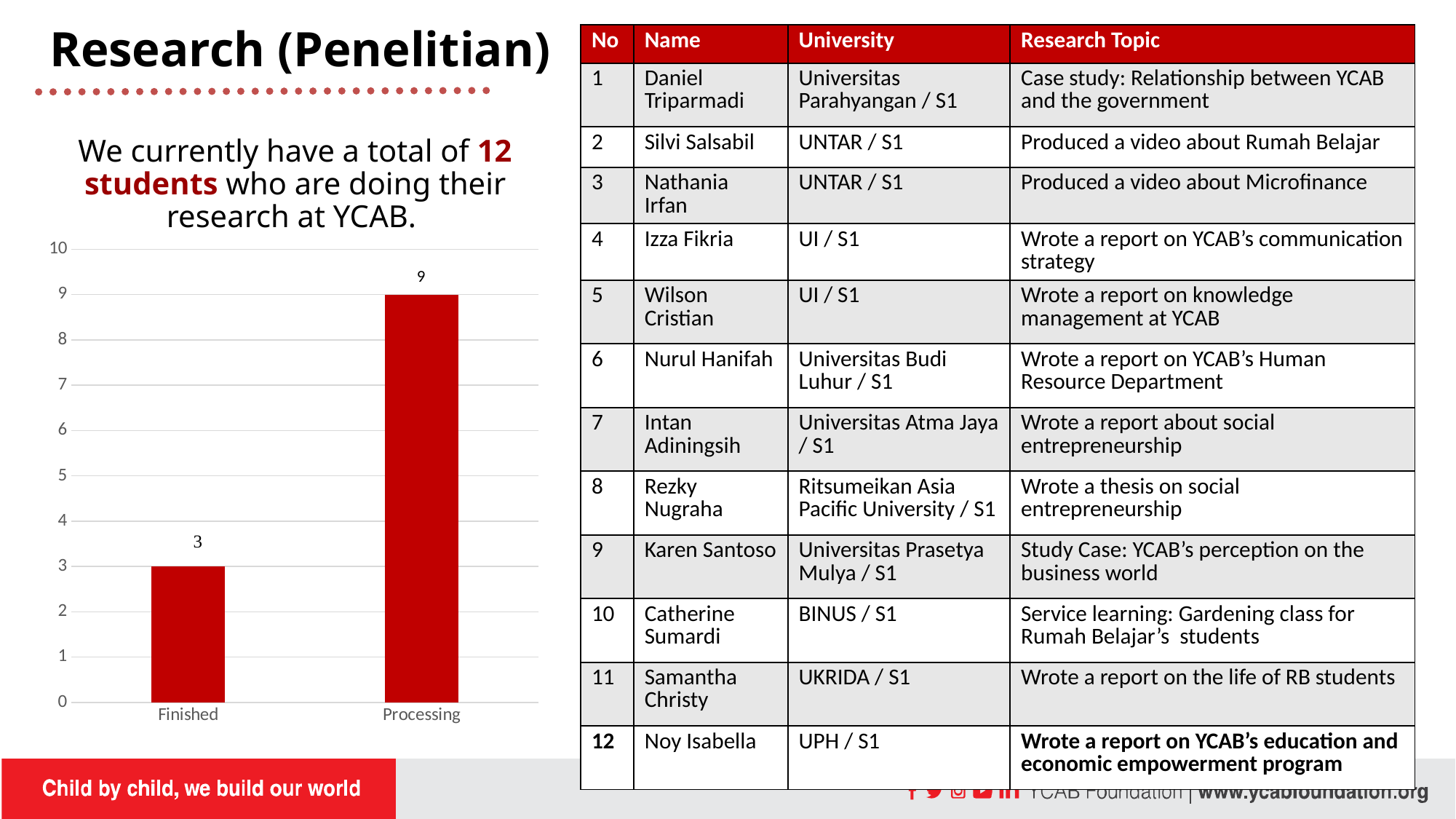
Which category has the highest value? Processing Which is larger, Finished or Processing? Processing What kind of chart is shown on the slide? bar chart Is the value for Finished greater or less than 5? less Which category has the lowest value? Finished Is the value for Processing greater or less than 8? greater What is the value for Finished? 3 How many categories are shown on the chart? 2 What is the highest value shown on the chart's vertical axis? 10 What colour are the bars in the chart? red What is the difference between the Processing and Finished values? 6 What is the value for Processing? 9